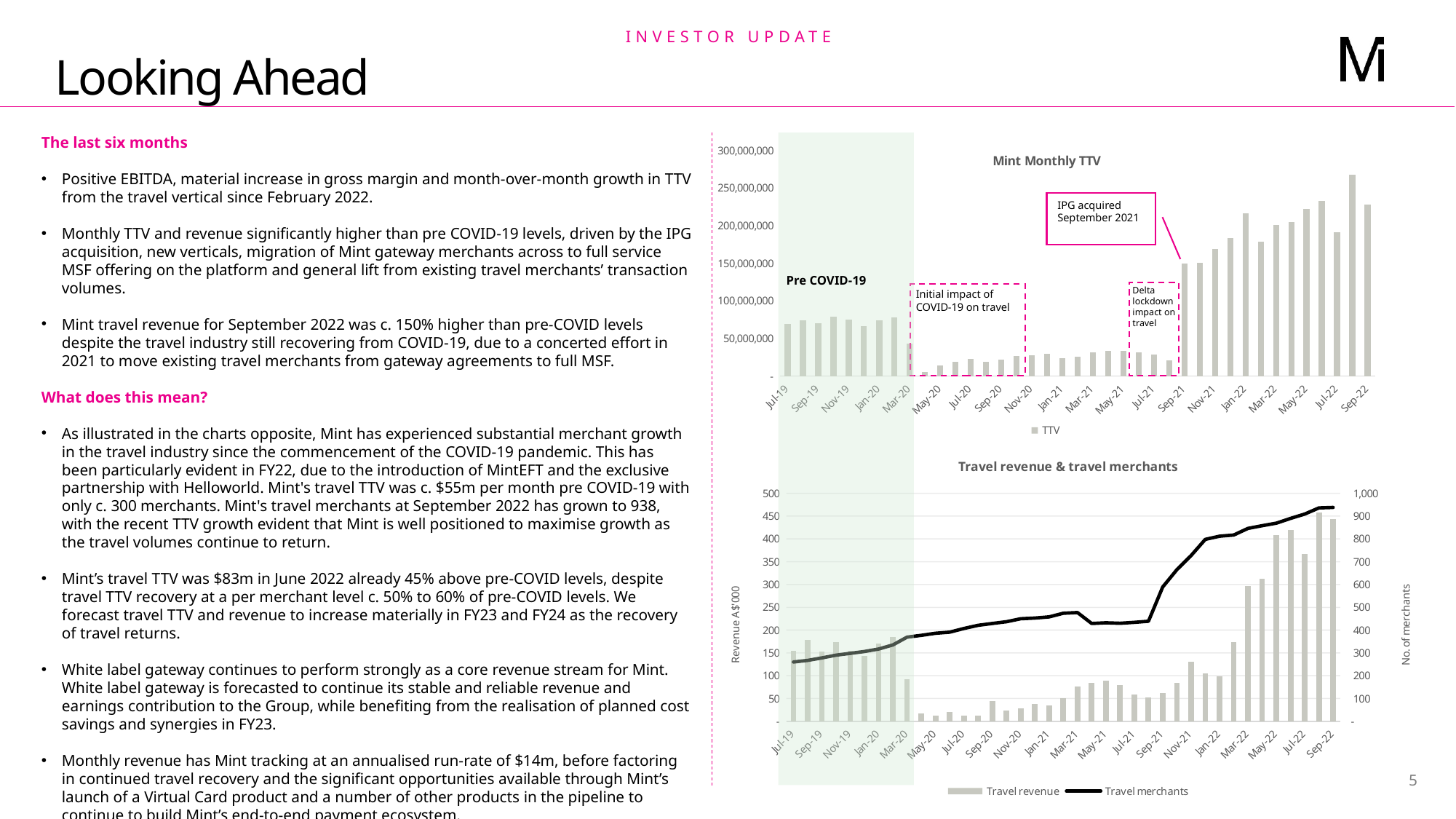
In the Mint Monthly TTV chart, which month has the highest TTV? Aug-22 In the Mint Monthly TTV chart, which is larger, the TTV for Jan-22 or the TTV for Jan-21? Jan-22 In the Travel revenue & travel merchants chart, does the Travel merchants line generally rise or fall from Jul-19 to Sep-22? Rise In the Mint Monthly TTV chart, is the value for Apr-20 greater or less than 50,000,000? less In the Travel revenue & travel merchants chart, is the Travel merchants value for Sep-22 greater or less than 900? greater In the Mint Monthly TTV chart, is the value for Aug-22 greater or less than 250,000,000? greater What kind of chart is the Mint Monthly TTV chart? Bar chart How many series does the legend of the Mint Monthly TTV chart list? 1 According to the annotation on the Mint Monthly TTV chart, when was IPG acquired? September 2021 In the Mint Monthly TTV chart, which month has the lowest TTV? Apr-20 How many series does the legend of the Travel revenue & travel merchants chart list? 2